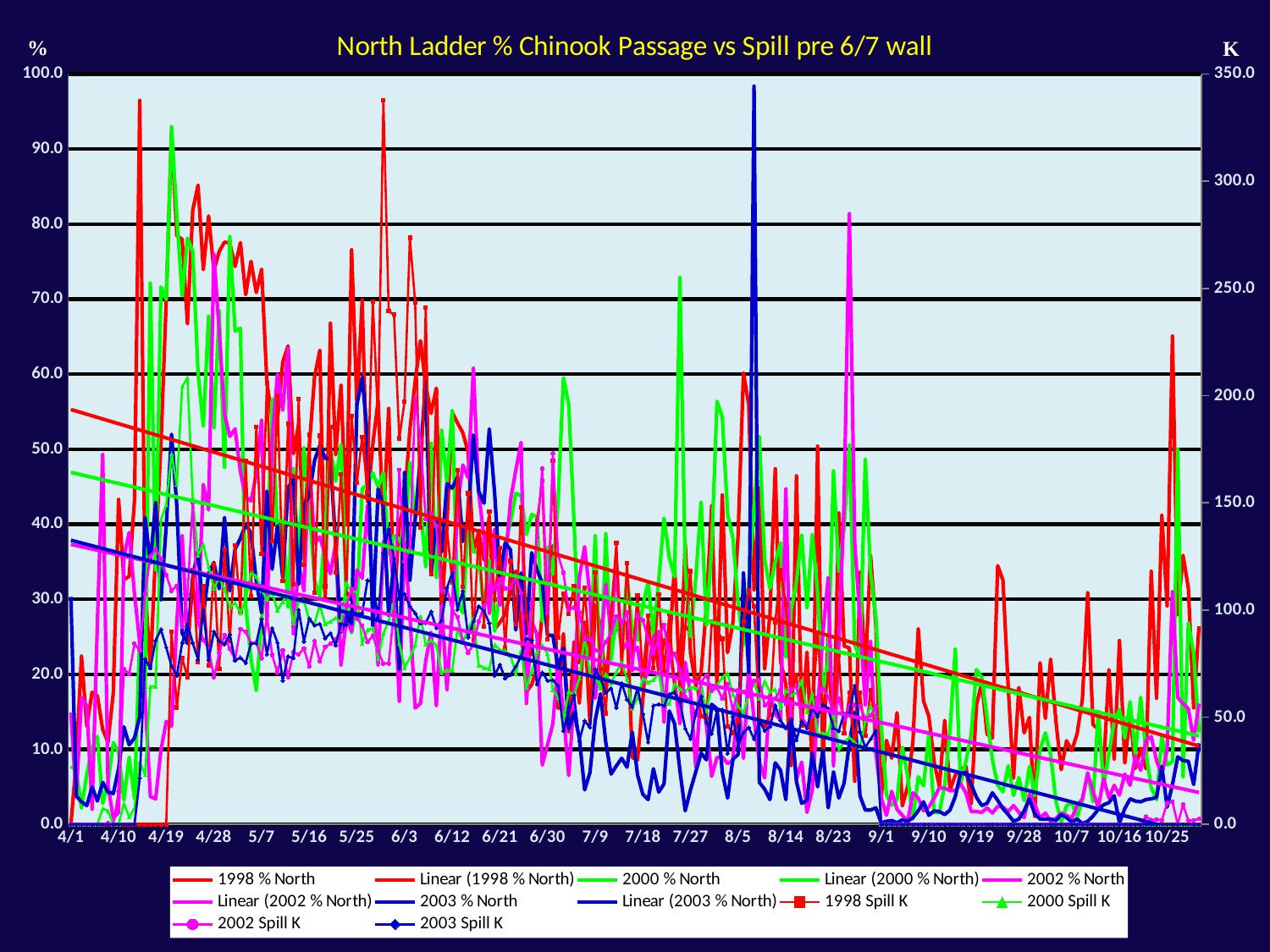
Does the Linear (2003 % North) trend line rise or fall across the x axis? fall At 4/1, is the Linear (2000 % North) trend line greater or less than 50.0 on the left axis? less Which of the four linear trend lines is the highest at 4/1? Linear (1998 % North) At 4/1, is the Linear (2002 % North) trend line greater or less than 30.0 on the left axis? greater At 4/1, which linear trend line is higher: Linear (1998 % North) or Linear (2000 % North)? Linear (1998 % North) What is the maximum value shown on the left (%) axis? 100.0 Does the Linear (1998 % North) trend line rise or fall from 4/1 to 10/25? fall How many series does the legend list? 12 What is the title of the chart? North Ladder % Chinook Passage vs Spill pre 6/7 wall What kind of chart is shown on the slide? line chart At 4/1, is the Linear (1998 % North) trend line greater or less than 50.0 on the left axis? greater How many date labels are shown along the x axis? 24